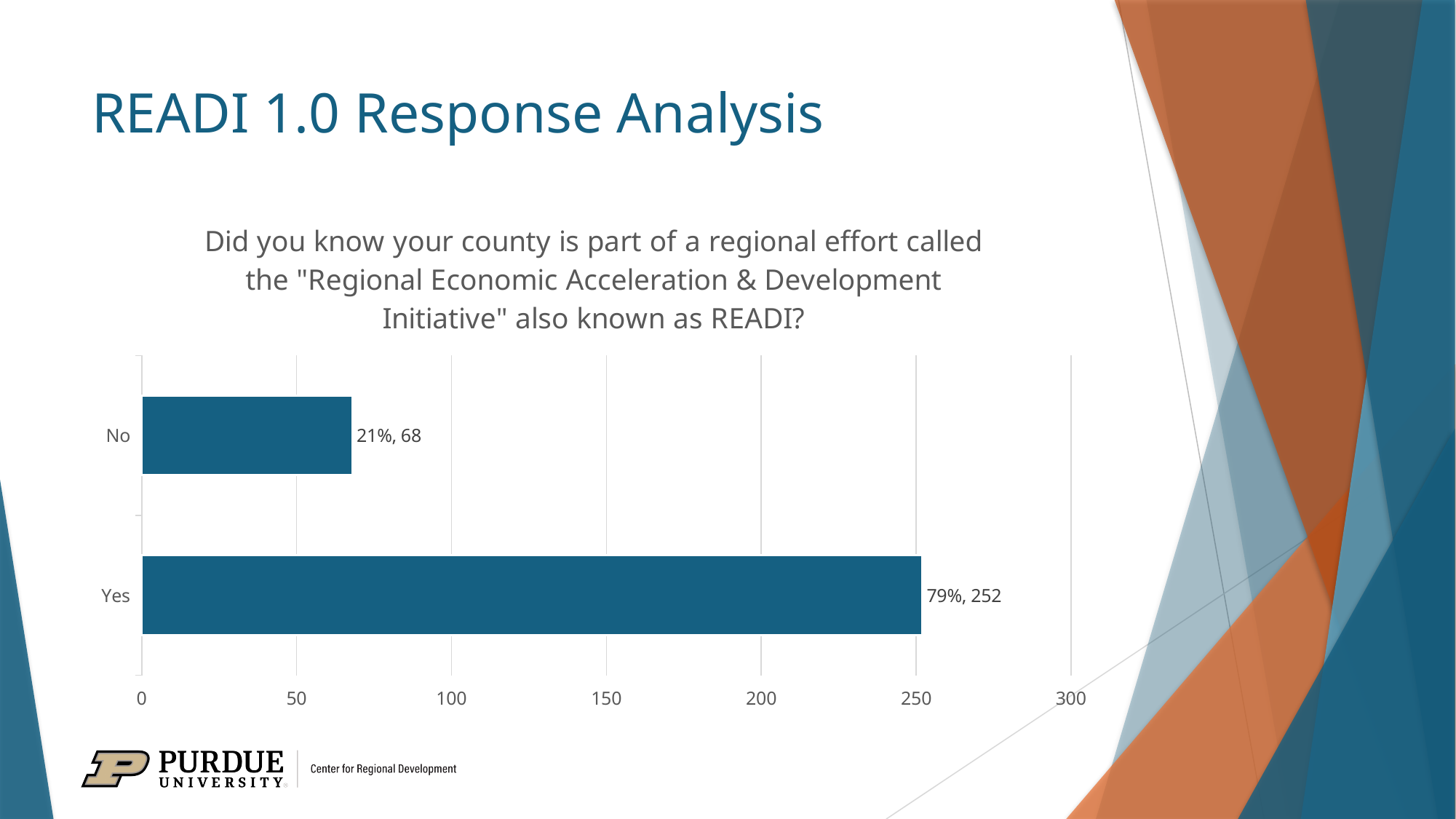
What percentage of respondents answered "No"? 21% What percentage of respondents answered "Yes"? 79% What is the total number of responses across both categories? 320 What kind of chart is shown on the slide? bar chart What is the count of respondents who answered "No"? 68 Which response category has the highest count? Yes Which is larger, the count for "Yes" or the count for "No"? Yes Is the value for "Yes" greater or less than 200? greater Which response category has the lowest count? No What is the difference between the "Yes" count and the "No" count? 184 How many response categories are shown in the chart? 2 What is the count of respondents who answered "Yes"? 252